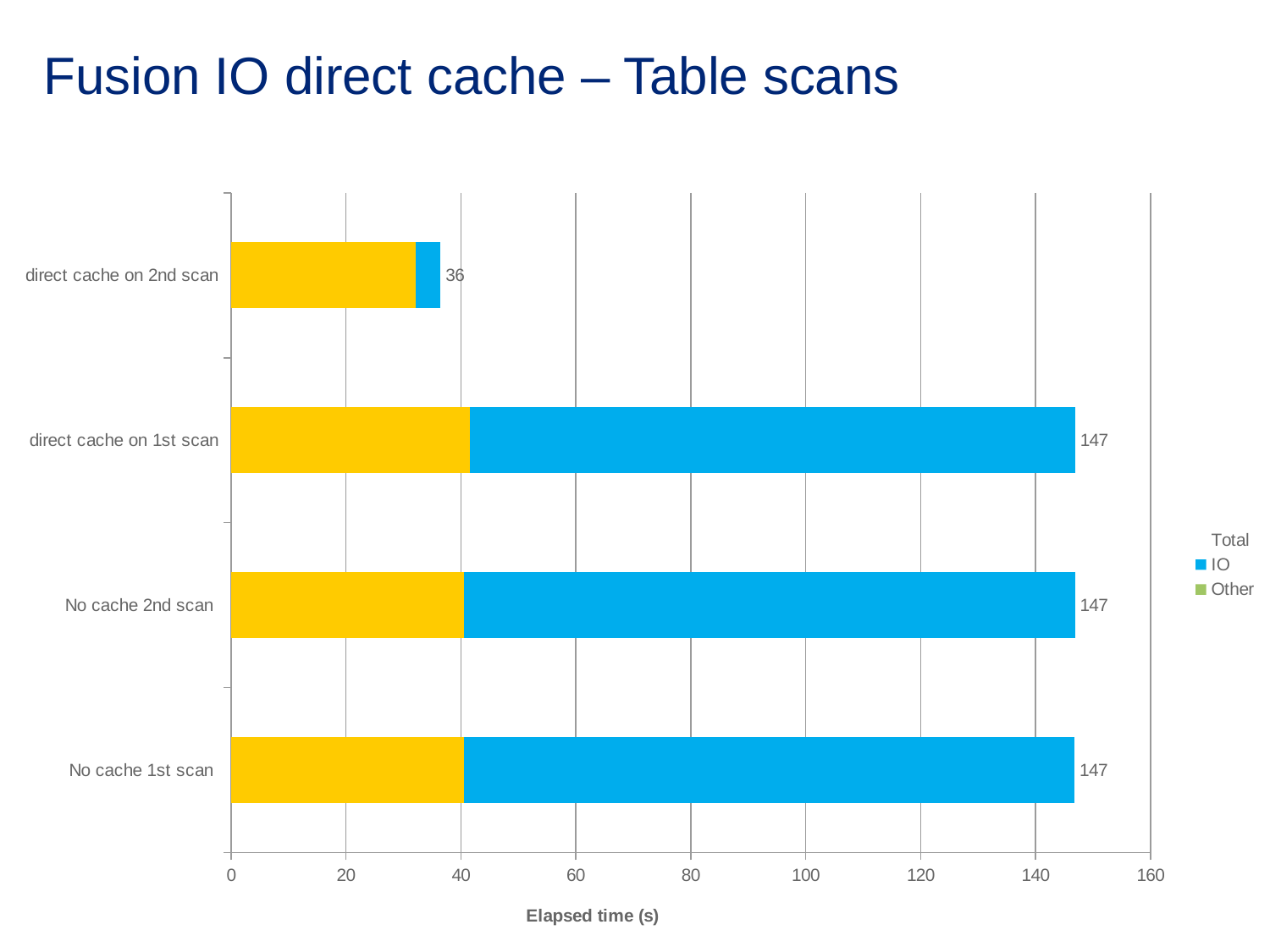
Which category has the lowest total elapsed time? direct cache on 2nd scan How many categories (bars) are shown in the chart? 4 What is the title of the horizontal axis? Elapsed time (s) Which has the larger total elapsed time, 'direct cache on 1st scan' or 'direct cache on 2nd scan'? direct cache on 1st scan What kind of chart is shown on the slide? Stacked bar chart Is the yellow segment of the 'direct cache on 2nd scan' bar greater or less than 40? less What is the total elapsed time labelled for the 'direct cache on 1st scan' bar? 147 What is the difference in total elapsed time between 'direct cache on 1st scan' and 'direct cache on 2nd scan'? 111 Is the total for 'No cache 2nd scan' greater or less than 140? greater What is the total elapsed time labelled for the 'No cache 1st scan' bar? 147 Do 'No cache 1st scan' and 'No cache 2nd scan' have the same labelled total elapsed time? Yes What is the total elapsed time labelled for the 'direct cache on 2nd scan' bar? 36